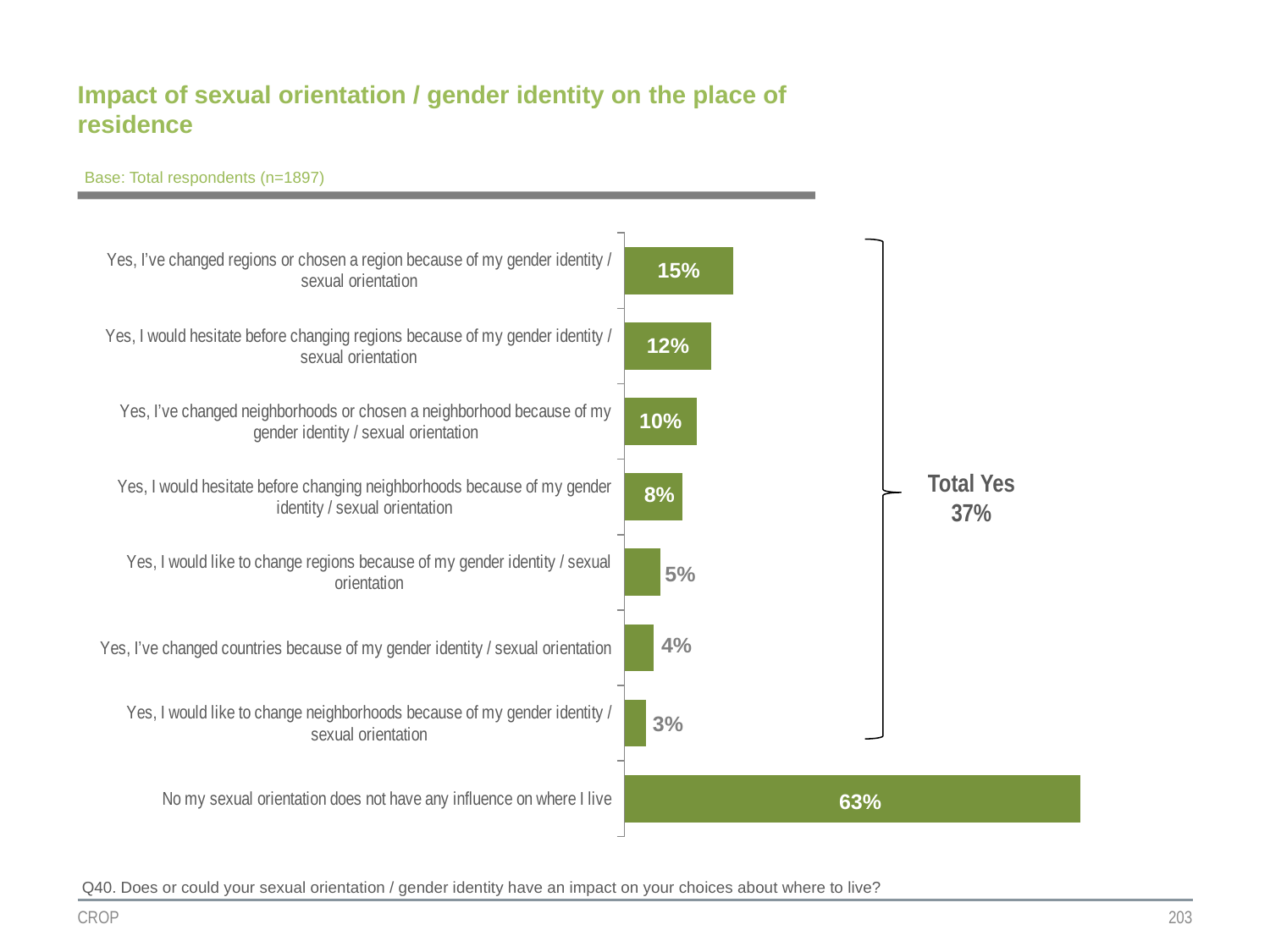
What is the base (number of respondents) stated on the slide? Total respondents (n=1897) Which is larger: the value for 'Yes, I've changed neighborhoods or chosen a neighborhood' or the value for 'Yes, I would like to change regions'? Yes, I've changed neighborhoods or chosen a neighborhood Which category has the highest value on the chart? No my sexual orientation does not have any influence on where I live What is the value for 'Yes, I've changed countries because of my gender identity / sexual orientation'? 4% What percentage of respondents said their sexual orientation does not have any influence on where they live? 63% What kind of chart is shown on the slide? Bar chart What percentage said they would hesitate before changing neighborhoods because of their gender identity / sexual orientation? 8% What is the 'Total Yes' percentage shown next to the bracket on the chart? 37% What is the value for 'Yes, I've changed regions or chosen a region because of my gender identity / sexual orientation'? 15% Which category has the lowest value on the chart? Yes, I would like to change neighborhoods because of my gender identity / sexual orientation What is the difference between 'Yes, I've changed regions or chosen a region' (15%) and 'Yes, I would hesitate before changing regions' (12%)? 3% How many categories are shown on the chart? 8